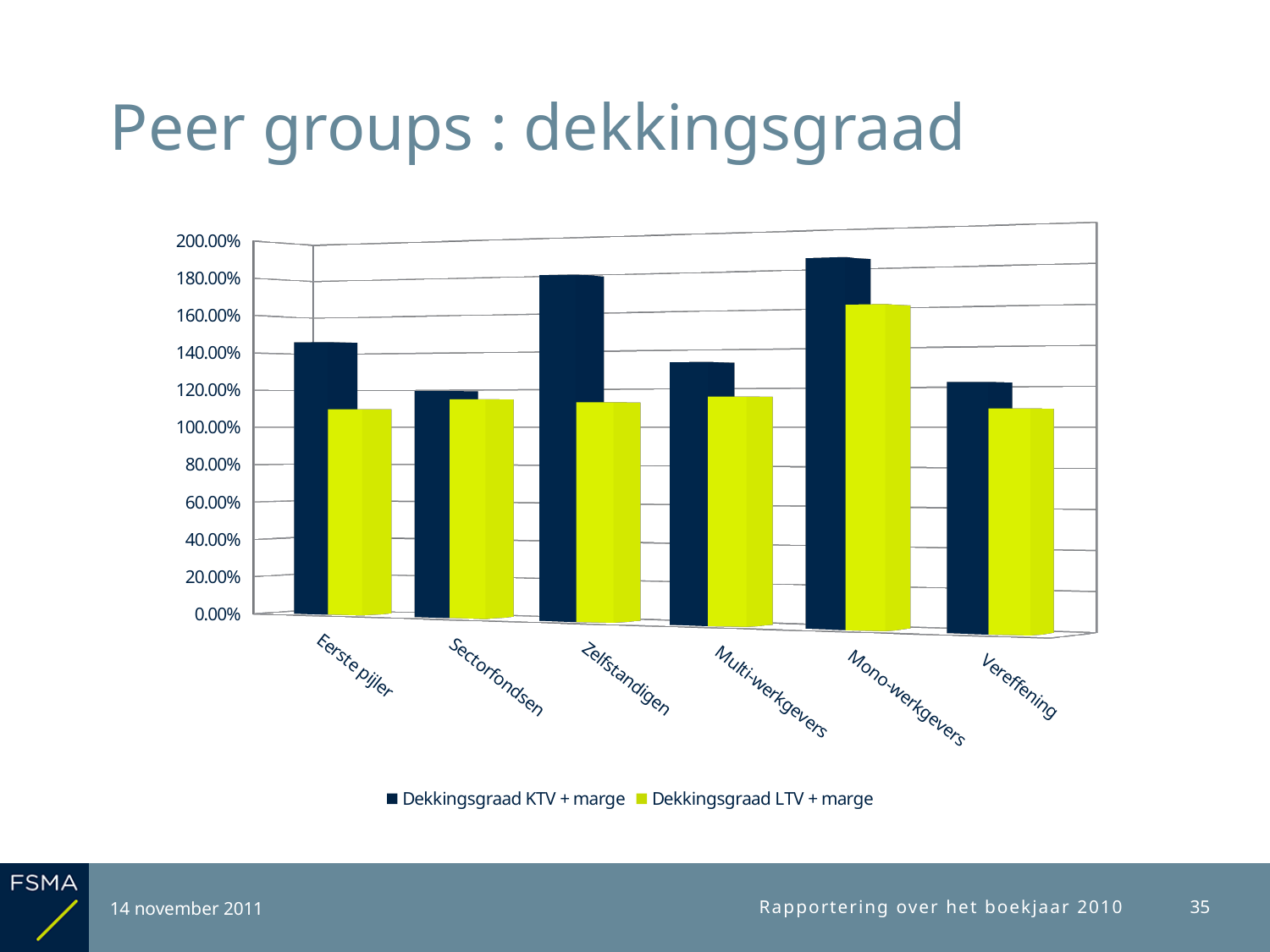
For Dekkingsgraad KTV + marge, which is larger: Zelfstandigen or Multi-werkgevers? Zelfstandigen Is the value for Dekkingsgraad LTV + marge for Eerste pijler greater or less than 120.00%? less How many series does the legend list? 2 Is the value for Dekkingsgraad LTV + marge for Mono-werkgevers greater or less than 140.00%? greater Is the value for Dekkingsgraad KTV + marge for Sectorfondsen greater or less than 140.00%? less How many peer group categories are shown on the x axis? 6 Which category has the highest value for Dekkingsgraad KTV + marge? Mono-werkgevers What kind of chart is shown on the slide? Bar chart What is the title of the slide containing the chart? Peer groups : dekkingsgraad Which category has the highest value for Dekkingsgraad LTV + marge? Mono-werkgevers For Mono-werkgevers, which is larger: Dekkingsgraad KTV + marge or Dekkingsgraad LTV + marge? Dekkingsgraad KTV + marge